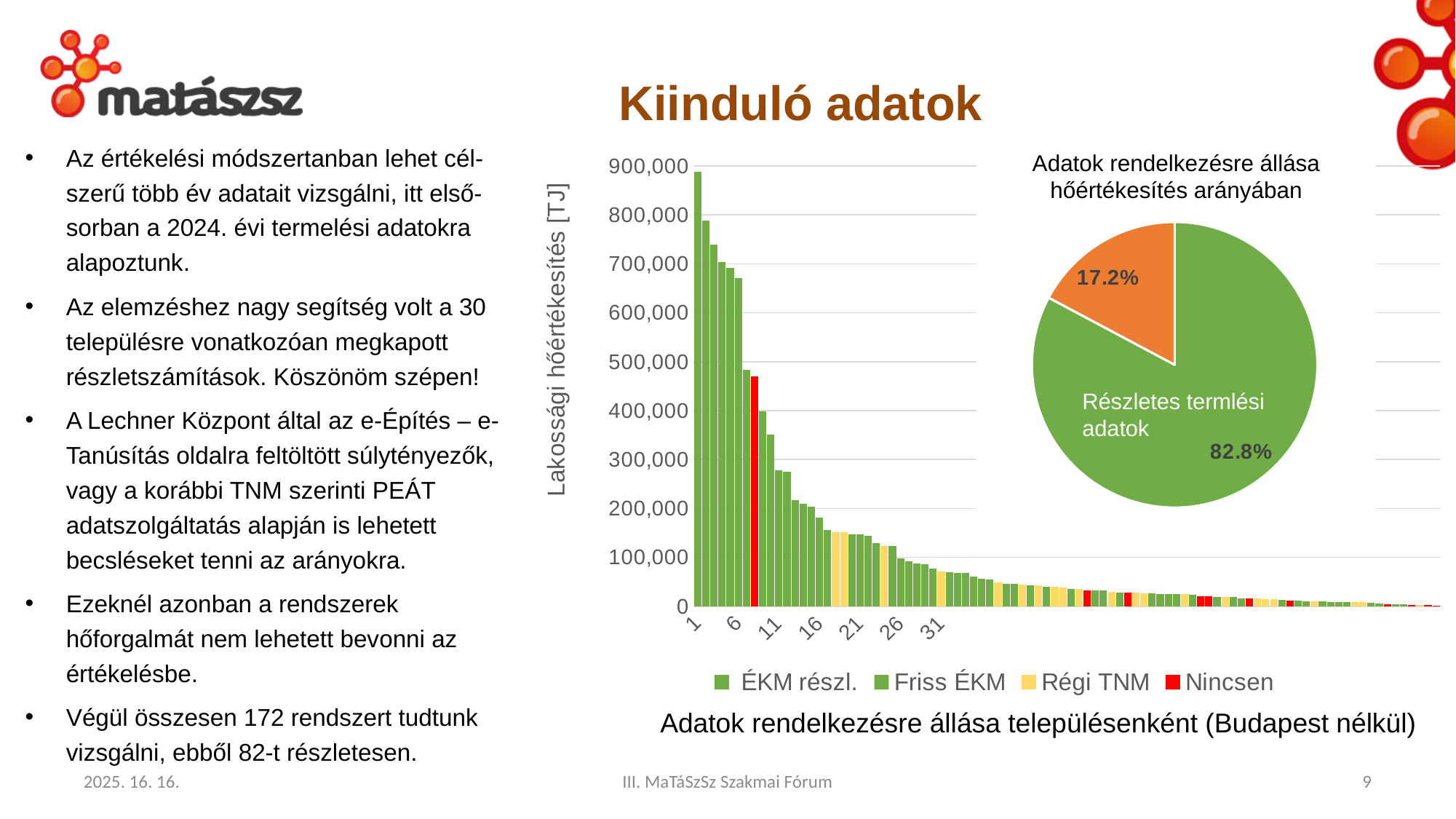
What is the y-axis label of the bar chart 'Adatok rendelkezésre állása településenként (Budapest nélkül)'? Lakossági hőértékesítés [TJ] In the pie chart on the right, which slice is larger, the green one or the orange one? the green one (82.8%) How many slices does the pie chart on the right have? 2 In the pie chart titled 'Adatok rendelkezésre állása hőértékesítés arányában', what share does the 'Részletes termlési adatok' slice have? 82.8% In the bar chart 'Adatok rendelkezésre állása településenként (Budapest nélkül)', is the value for category 1 greater or less than 800,000? greater In the bar chart 'Adatok rendelkezésre állása településenként (Budapest nélkül)', which legend entry is shown in red? Nincsen In the bar chart 'Adatok rendelkezésre állása településenként (Budapest nélkül)', is the value for category 11 greater or less than 200,000? greater In the pie chart on the right, what is the difference in percentage points between the two slices? 65.6 percentage points What kind of chart is the chart titled 'Adatok rendelkezésre állása településenként (Budapest nélkül)'? bar chart In the bar chart 'Adatok rendelkezésre állása településenként (Budapest nélkül)', do the values rise or fall along the x axis? fall In the pie chart on the right, what is the value of the orange slice? 17.2% How many series does the legend of the bar chart 'Adatok rendelkezésre állása településenként (Budapest nélkül)' list? 4